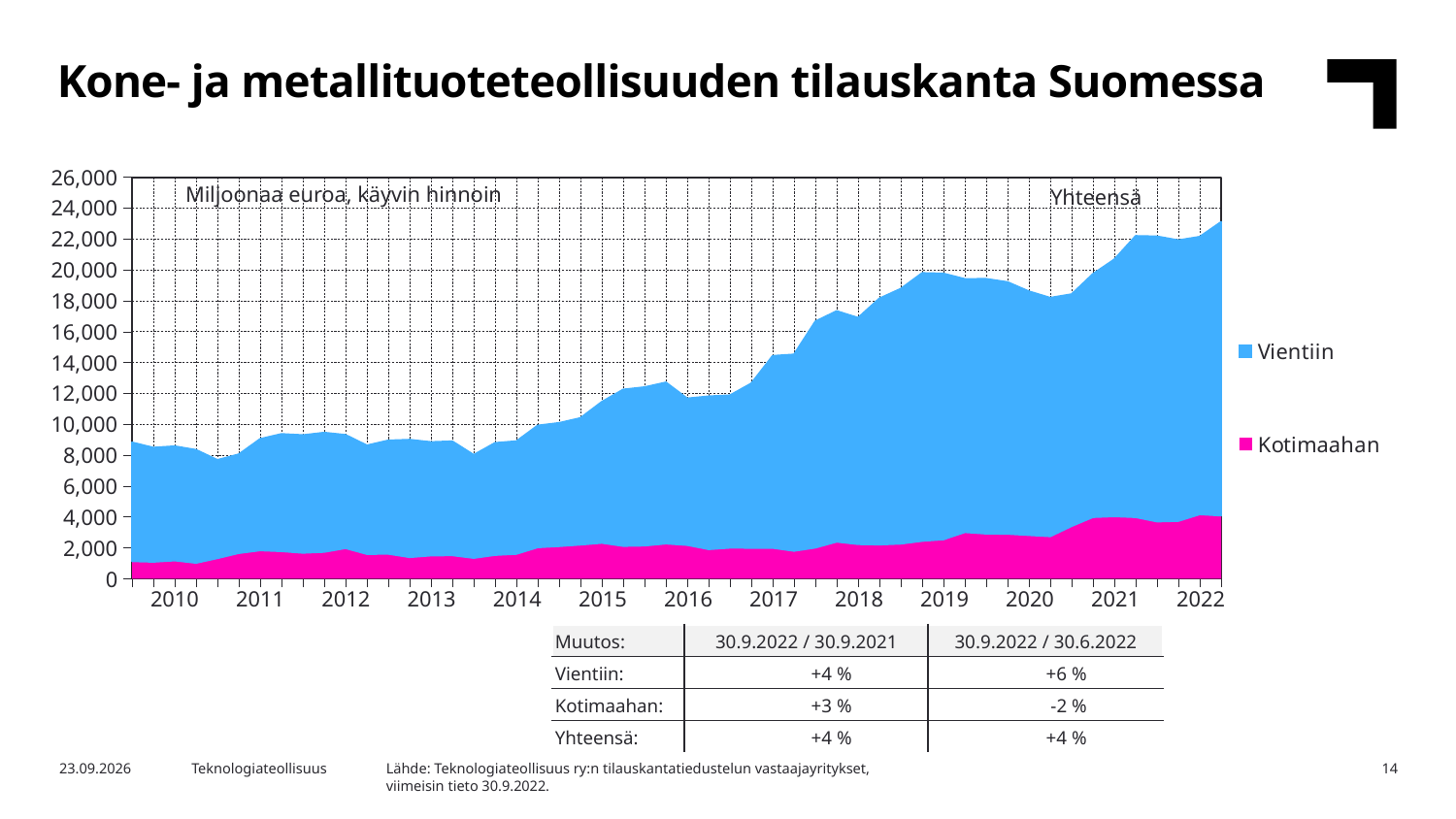
Is the total order backlog in 2016 greater or less than 14,000? less Which is larger, the total order backlog in 2022 or in 2010? 2022 How many years are labelled on the x axis of the chart? 13 Does the total order backlog generally rise or fall from 2010 to 2022? rise What unit is stated in the chart for the values? Miljoonaa euroa, käyvin hinnoin How many series does the chart legend list? 2 What kind of chart is shown on the slide? Stacked area chart Is the total order backlog (Yhteensä) at the end of 2022 greater or less than 20,000? greater Is the Kotimaahan value in 2021 greater or less than 2,000? greater Which two series are listed in the chart legend? Vientiin and Kotimaahan